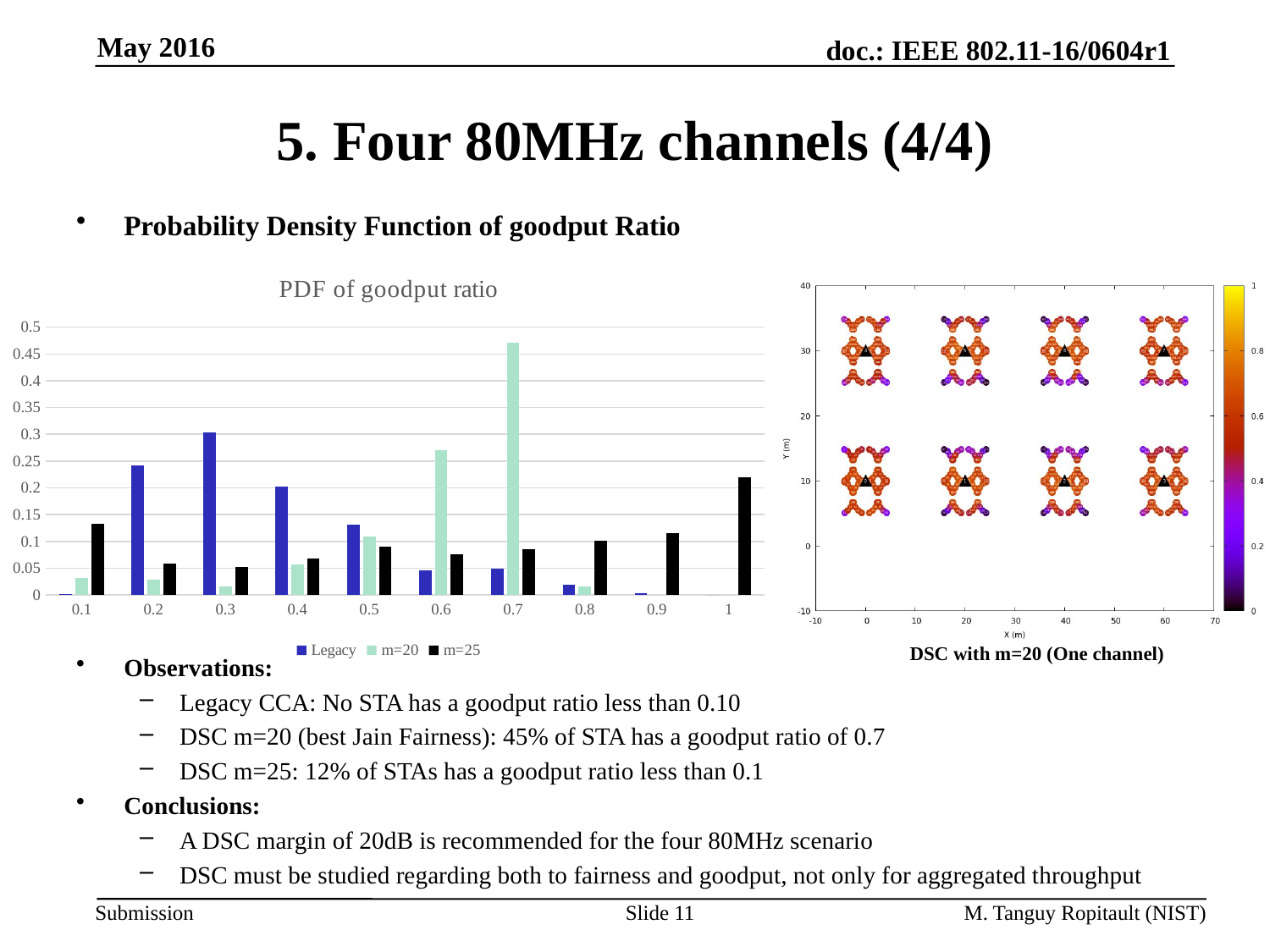
In the 'PDF of goodput ratio' chart, which series is drawn in black? m=25 In the 'PDF of goodput ratio' chart, what kind of chart is shown? bar chart In the 'PDF of goodput ratio' chart, at which goodput ratio does the m=20 series reach its highest value? 0.7 In the 'PDF of goodput ratio' chart, at which goodput ratio does the Legacy series reach its highest value? 0.3 In the 'PDF of goodput ratio' chart, at goodput ratio 0.6, which series has the larger value: m=20 or Legacy? m=20 In the 'PDF of goodput ratio' chart, is the m=25 value at goodput ratio 1 greater or less than 0.3? less In the 'PDF of goodput ratio' chart, is the Legacy value at goodput ratio 0.3 greater or less than 0.25? greater In the 'PDF of goodput ratio' chart, how many series does the legend list? 3 In the 'PDF of goodput ratio' chart, at goodput ratio 0.2, which series has the larger value: Legacy or m=25? Legacy In the 'PDF of goodput ratio' chart, how many goodput ratio categories are shown on the x axis? 10 In the 'PDF of goodput ratio' chart, is the m=20 value at goodput ratio 0.7 greater or less than 0.4? greater In the 'PDF of goodput ratio' chart, at which goodput ratio does the m=25 series reach its highest value? 1